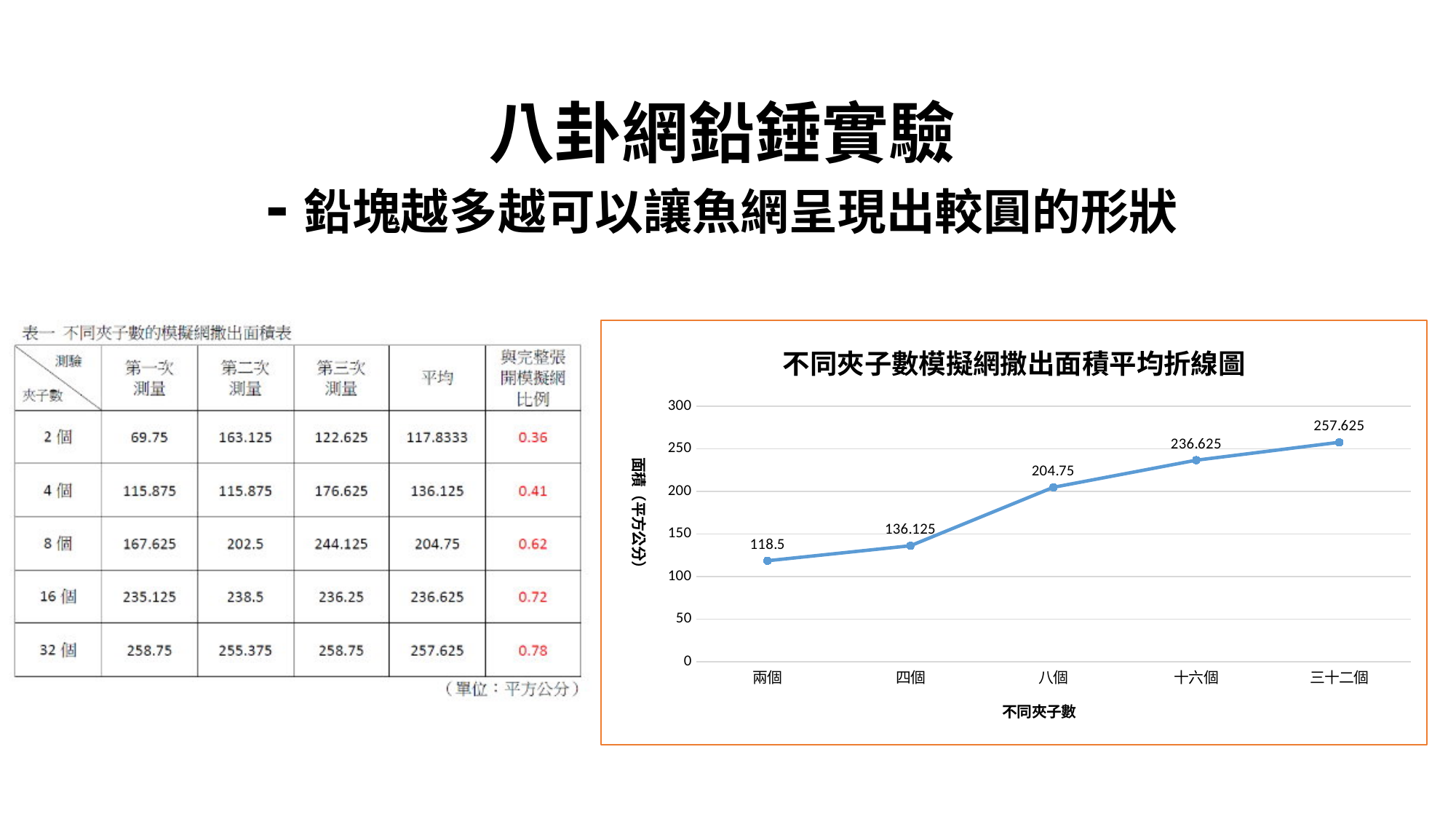
Which category has the highest value in the line chart? 三十二個 What kind of chart is shown on the slide? Line chart How many categories are plotted on the x axis of the line chart? 5 What is the value for 十六個 in the line chart? 236.625 What is the difference between the values for 三十二個 and 兩個? 139.125 What is the value for 三十二個 in the line chart? 257.625 What is the value for 兩個 in the line chart? 118.5 What is the value for 八個 in the line chart? 204.75 What is the value for 四個 in the line chart? 136.125 Which is larger, the value for 八個 or the value for 四個? 八個 Do the values rise or fall from 兩個 to 三十二個 along the x axis? Rise Which category has the lowest value in the line chart? 兩個